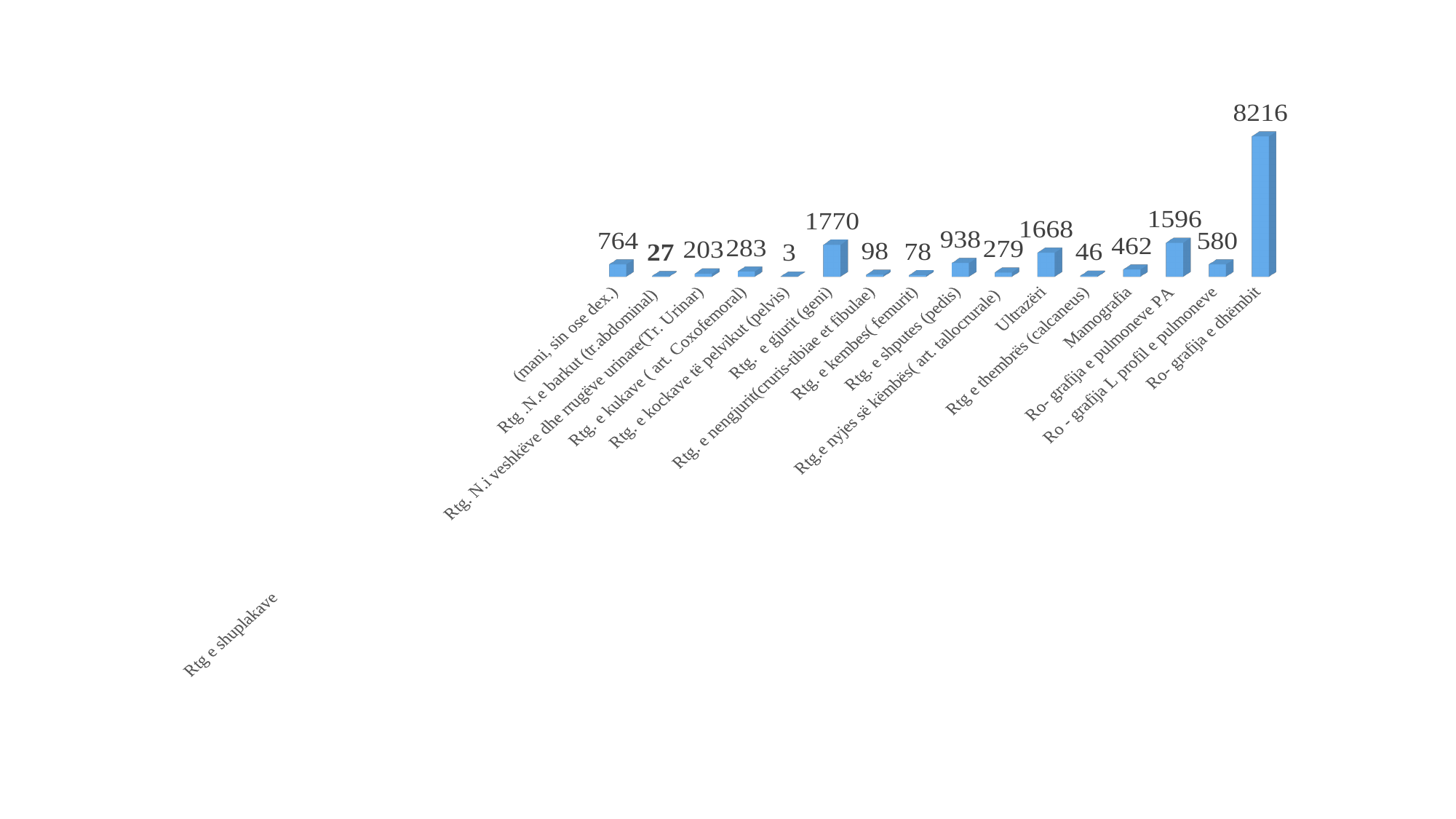
What kind of chart is shown on the slide? Bar chart What is the difference between the values for Ro- grafija e dhëmbit and Rtg. e gjurit (geni)? 6446 What is the value for Mamografia? 462 What is the difference between the values for Ro- grafija e pulmoneve PA and Ro - grafija L profil e pulmoneve? 1016 What is the value for Ultrazëri? 1668 Which is larger, the value for Rtg. e shputes (pedis) or the value for Mamografia? Rtg. e shputes (pedis) Which category has the highest value? Ro- grafija e dhëmbit Which category has the lowest value? Rtg. e kockave të pelvikut (pelvis) What is the value for Ro- grafija e pulmoneve PA? 1596 What is the value for Ro- grafija e dhëmbit? 8216 Which is larger, the value for Ultrazëri or the value for Rtg. e gjurit (geni)? Rtg. e gjurit (geni) What is the value for Rtg. e gjurit (geni)? 1770